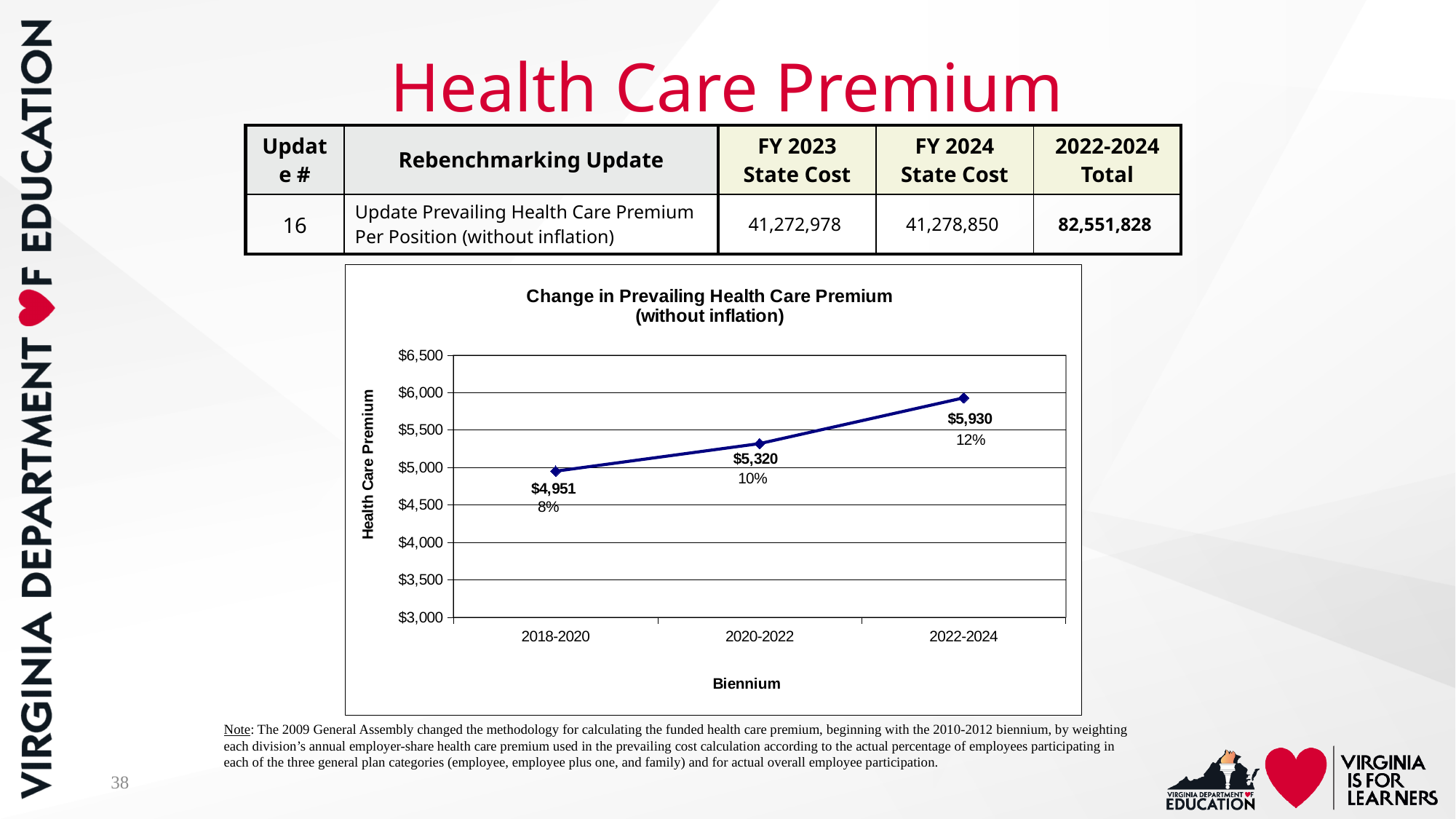
What is the difference in health care premium between the 2022-2024 and 2020-2022 bienniums? $610 What is the difference in health care premium between the 2020-2022 and 2018-2020 bienniums? $369 What percentage change is shown next to the 2022-2024 data point? 12% Which biennium has the highest health care premium? 2022-2024 What is the health care premium for the 2020-2022 biennium? $5,320 How many bienniums are plotted on the chart? 3 Is the health care premium for 2020-2022 greater or less than $5,000? greater What type of chart is used to show the change in prevailing health care premium? Line chart What is the health care premium for the 2022-2024 biennium? $5,930 What is the health care premium for the 2018-2020 biennium? $4,951 Does the health care premium rise or fall across the bienniums from 2018-2020 to 2022-2024? Rise Which biennium has the lowest health care premium? 2018-2020